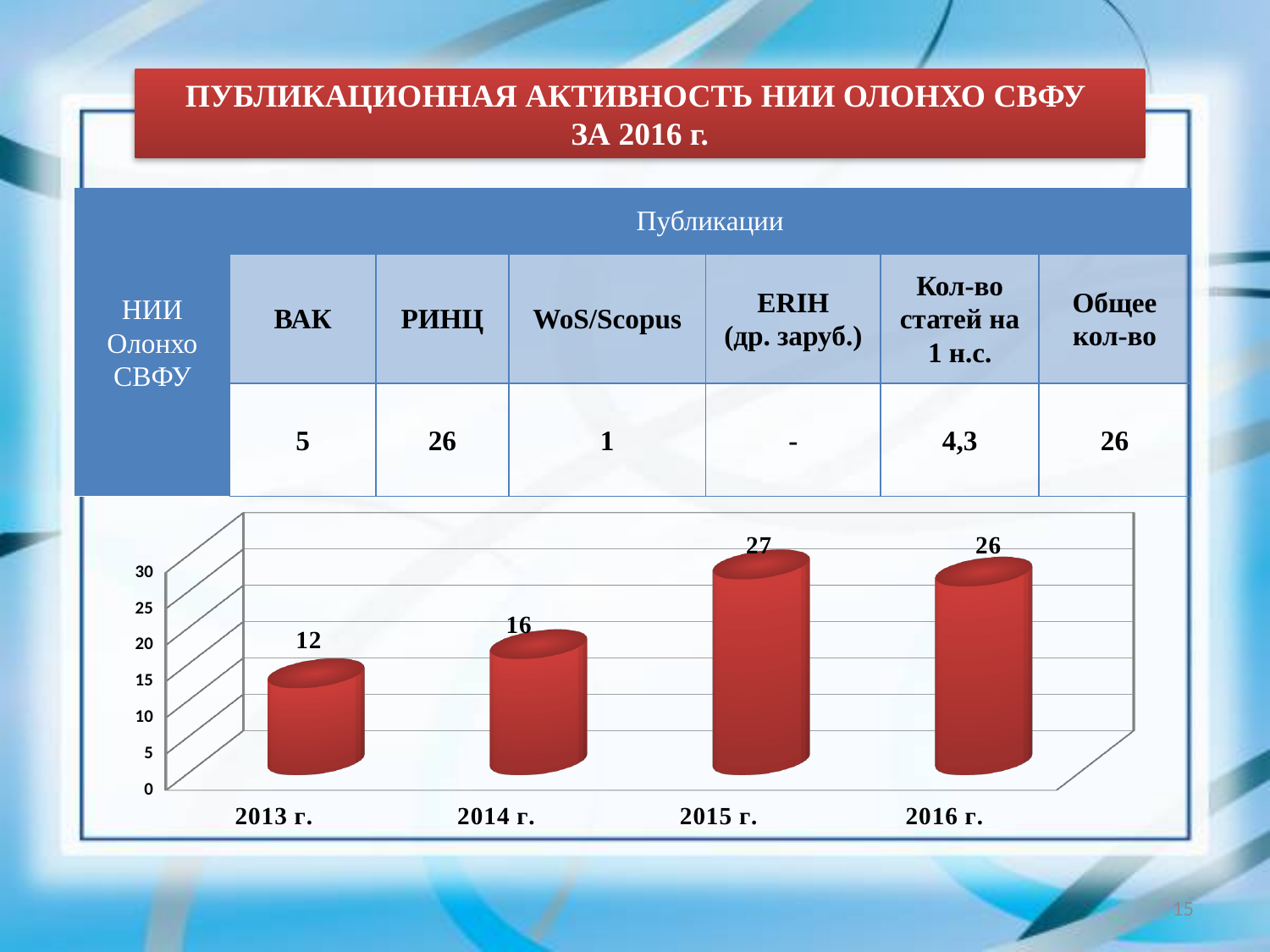
Which is larger in the bar chart, the value for 2014 г. or the value for 2016 г.? 2016 г. Which year has the lowest value in the bar chart? 2013 г. What kind of chart is shown at the bottom of the slide? bar chart What is the value for 2016 г. in the bar chart? 26 What is the difference between the values for 2015 г. and 2013 г. in the bar chart? 15 What is the value for 2013 г. in the bar chart? 12 Which year has the highest value in the bar chart? 2015 г. How many years are shown on the x axis of the bar chart? 4 What is the value for 2014 г. in the bar chart? 16 What is the difference between the values for 2014 г. and 2013 г. in the bar chart? 4 What is the value for 2015 г. in the bar chart? 27 What colour are the bars in the chart? red